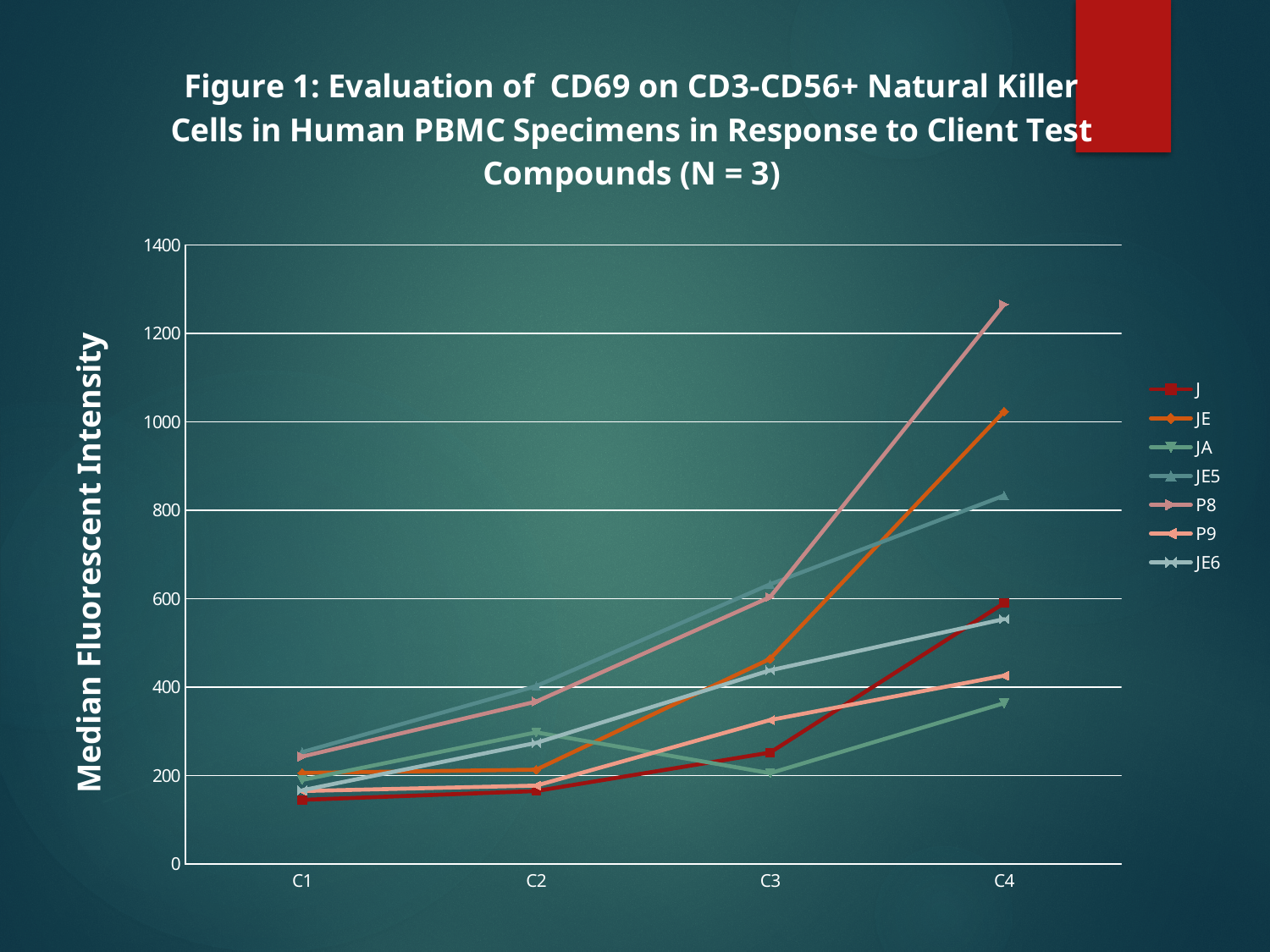
Which series has the lowest value at C4? JA At C4, which is larger: the value for JE5 or the value for JE6? JE5 What is the label of the y axis? Median Fluorescent Intensity Is the value for J at C1 greater or less than 200? less Which series has the highest value at C4? P8 What kind of chart is shown on the slide? line chart Is the value for JA at C4 greater or less than 400? less How many series does the legend list? 7 Does the value for P8 rise or fall from C1 to C4? rise Which series has the highest value at C1? JE5 How many categories are shown on the x axis? 4 Is the value for P8 at C4 greater or less than 1200? greater